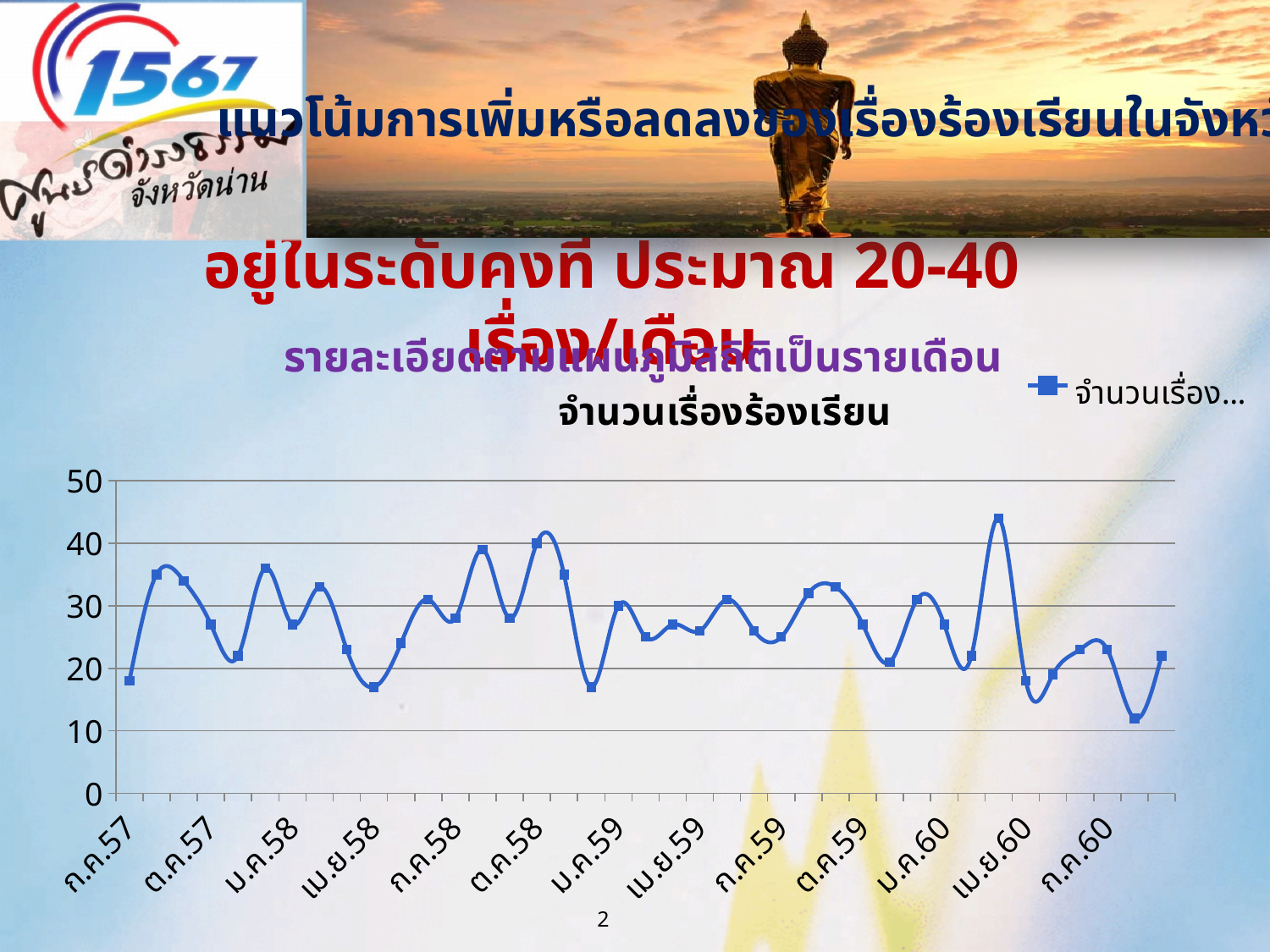
Is the highest point on the line greater or less than 50? less What is the title of the chart? จำนวนเรื่องร้องเรียน Is the value for ก.ค.57 greater or less than 20? less Is the lowest point on the line greater or less than 10? greater How many category labels are shown on the x axis? 13 What is the first category label on the x axis? ก.ค.57 What kind of chart is shown on the slide? line chart How many series does the legend list? 1